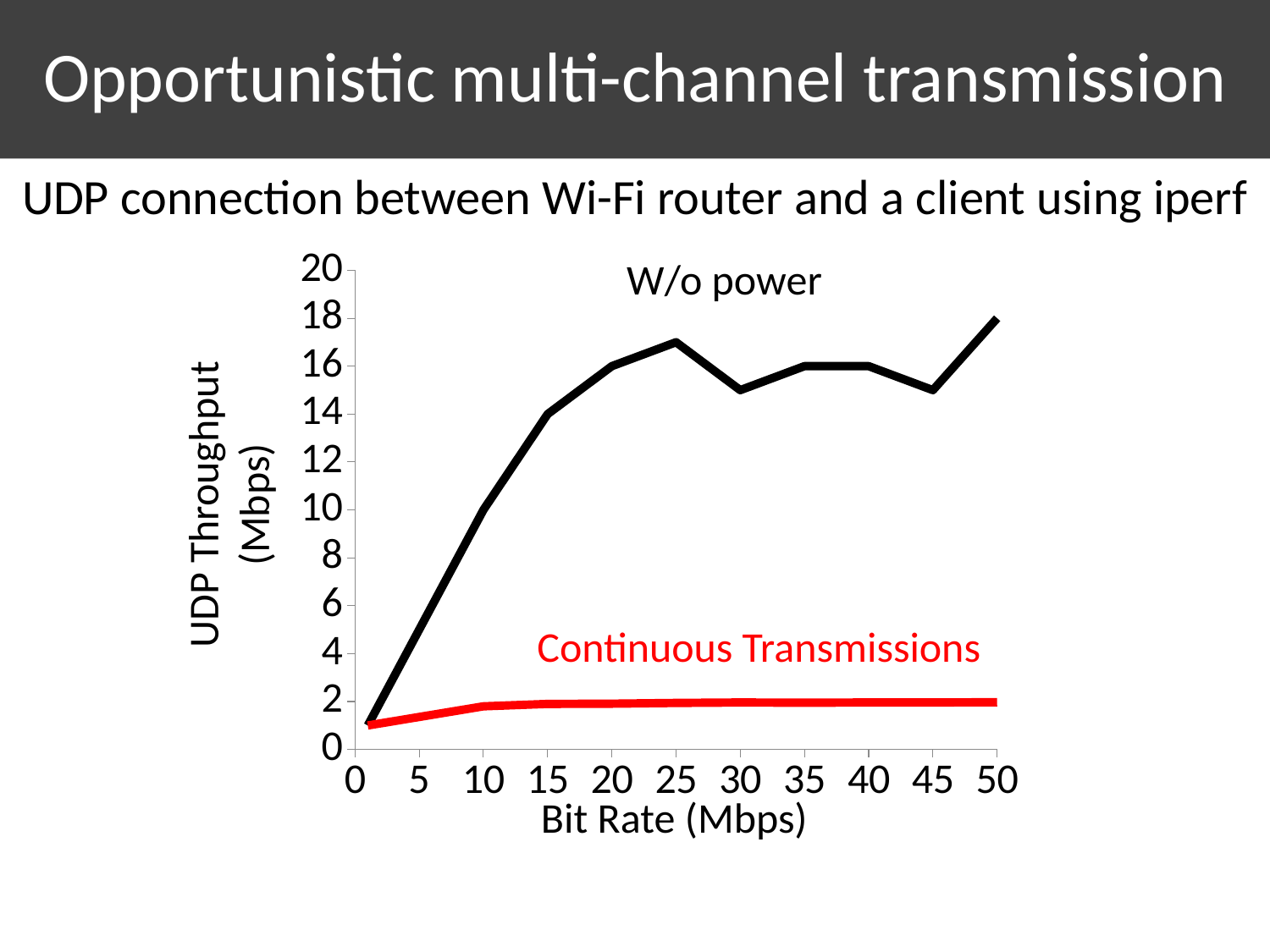
What is the label of the y axis? UDP Throughput (Mbps) How many tick marks are labelled on the x axis? 11 At a bit rate of 50 Mbps, which series has the higher UDP throughput, W/o power or Continuous Transmissions? W/o power Is the W/o power value at a bit rate of 30 Mbps greater or less than 16? less What kind of chart is shown on the slide? line chart At which bit rate does the W/o power series reach its highest UDP throughput? 50 Is the Continuous Transmissions value at a bit rate of 50 Mbps greater or less than 4? less Does the W/o power series rise or fall as the bit rate increases from 0 to 25 Mbps? rise Is the W/o power value at a bit rate of 25 Mbps greater or less than 16? greater What is the label of the x axis? Bit Rate (Mbps) How many series are plotted on the chart? 2